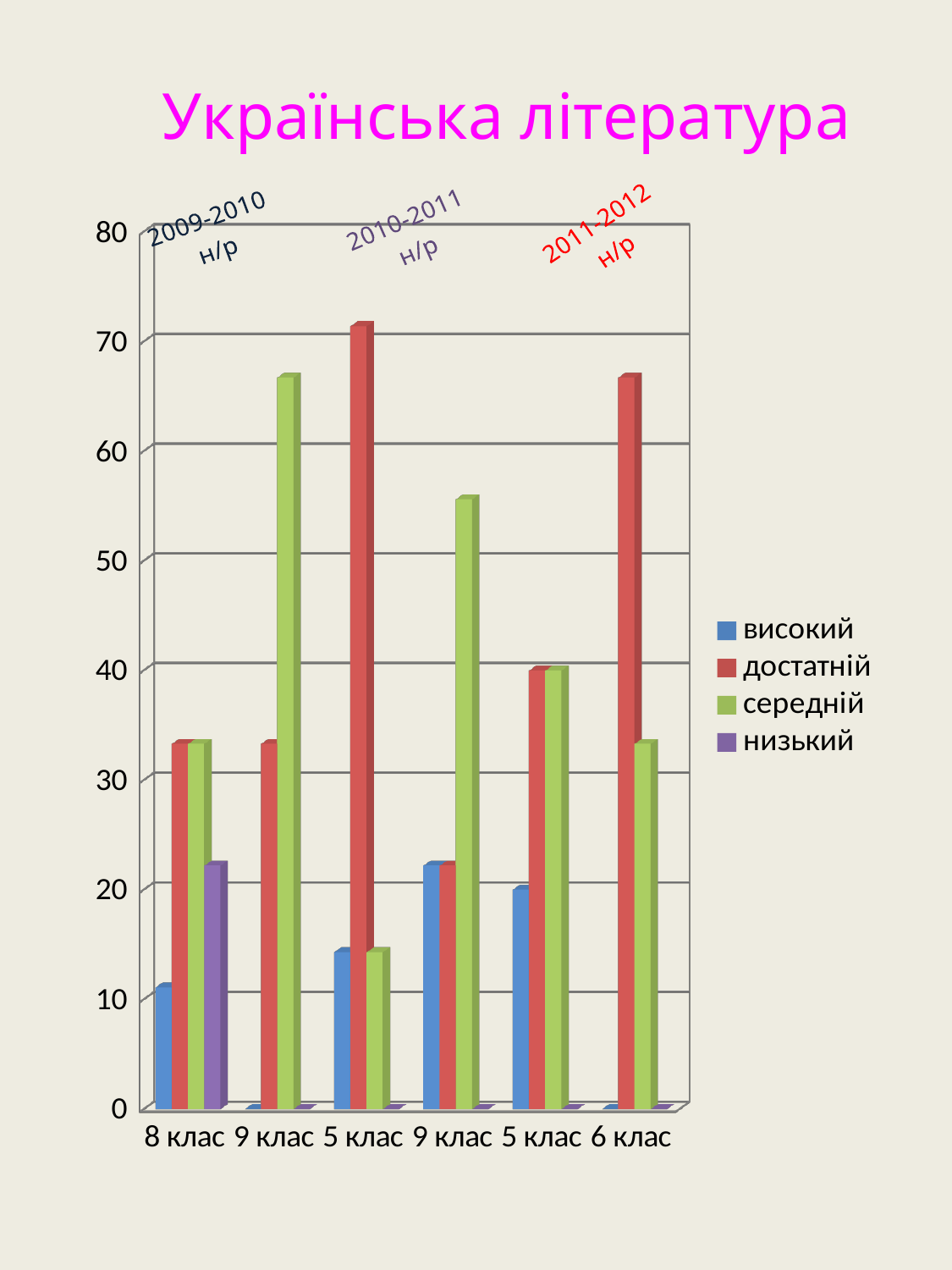
Which series has the lowest bar for 8 клас? високий Which is the only category that has a низький bar? 8 клас Is the високий value for 8 клас greater or less than 20? less For 6 клас, which is larger: the достатній value or the середній value? достатній Is the достатній value for 5 клас in 2010-2011 greater or less than 60? greater Is the середній value for 9 клас in 2009-2010 greater or less than 60? greater What is the title of the slide above the chart? Українська література How many class categories are shown along the x axis? 6 What kind of chart is shown on the slide? bar chart For 8 клас, which is larger: the високий value or the низький value? низький How many series does the legend list? 4